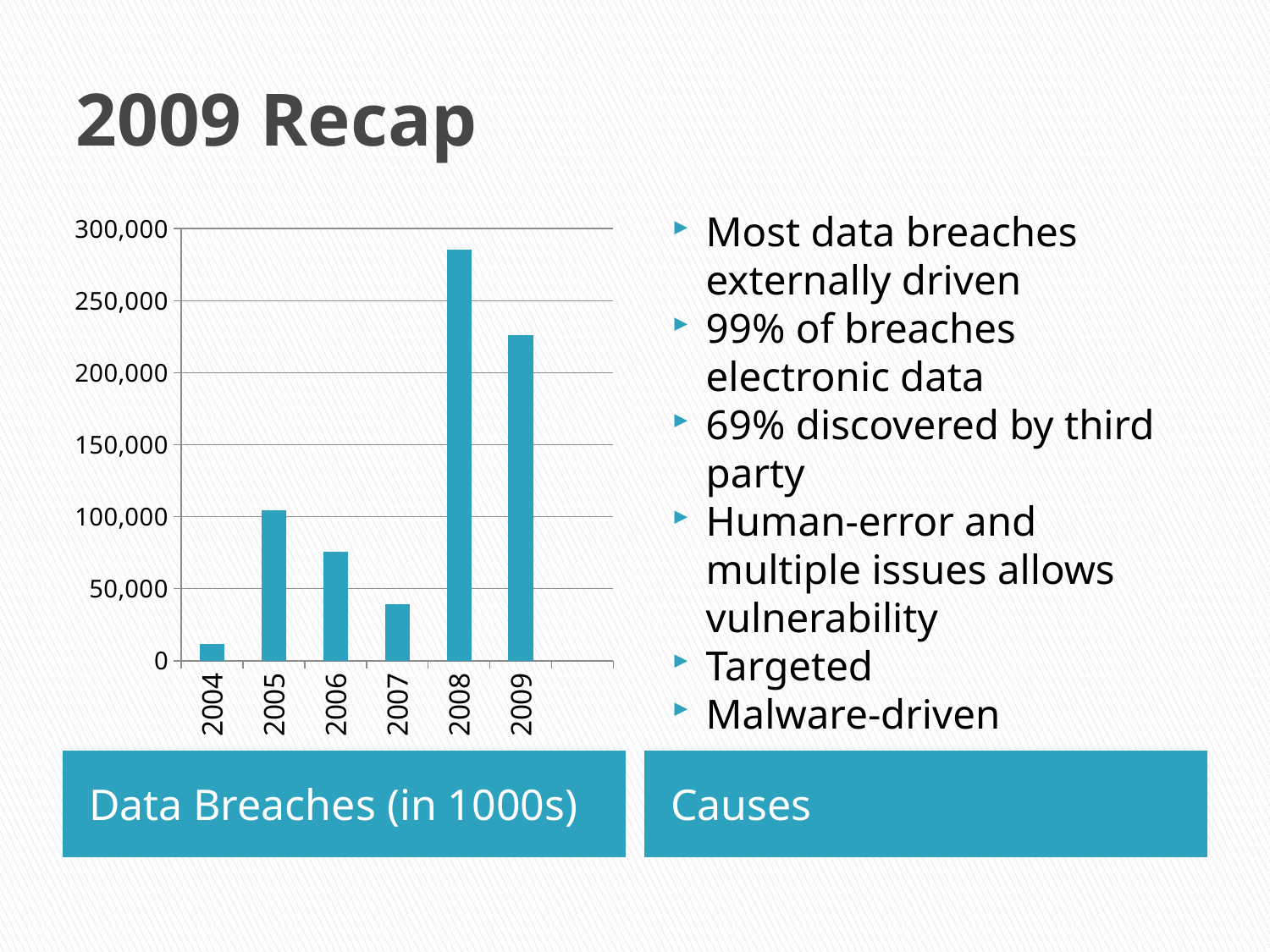
What kind of chart is shown on the slide? Bar chart Is the value for 2009 greater or less than 200,000? greater Is the value for 2007 greater or less than 50,000? less Which year has the larger value, 2005 or 2006? 2005 Is the value for 2006 greater or less than 50,000? greater Does the value rise or fall from 2008 to 2009? fall Which year has the lowest value in the chart? 2004 How many years are shown on the x axis of the chart? 6 Which year has the larger value, 2009 or 2008? 2008 What is the caption shown beneath the chart? Data Breaches (in 1000s) Which year has the highest value in the chart? 2008